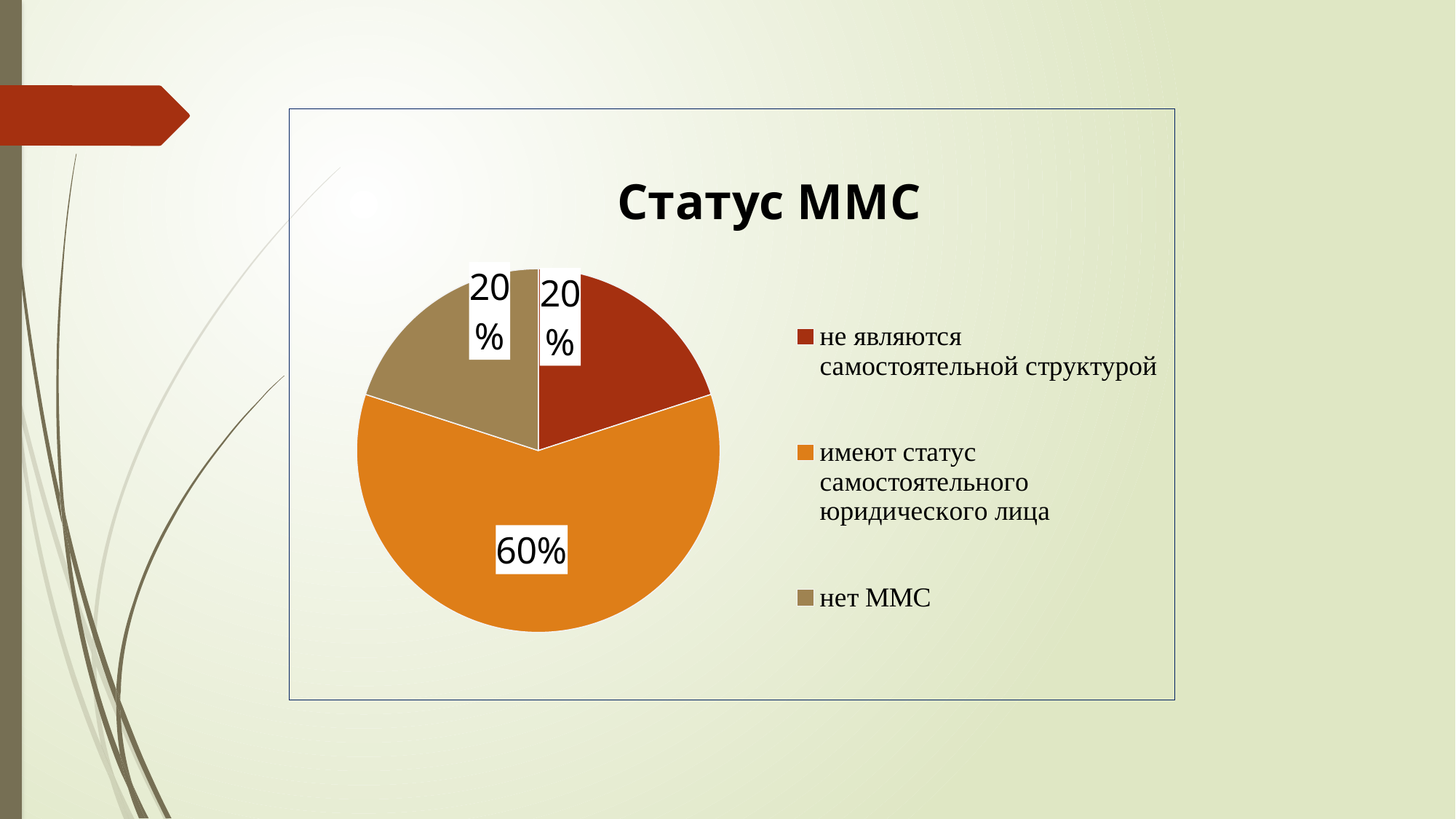
What is the difference between the share for 'имеют статус самостоятельного юридического лица' and the share for 'нет ММС'? 40% What is the combined share of 'не являются самостоятельной структурой' and 'нет ММС'? 40% What kind of chart is shown on the slide? pie chart What is the title of the chart? Статус ММС What share of the pie is 'нет ММС'? 20% How many entries does the legend list? 3 Which category has the largest slice of the pie? имеют статус самостоятельного юридического лица What colour is the slice for 'нет ММС'? brown How many slices does the pie chart have? 3 Which is larger: the share for 'имеют статус самостоятельного юридического лица' or the share for 'не являются самостоятельной структурой'? имеют статус самостоятельного юридического лица What share of the pie is 'имеют статус самостоятельного юридического лица'? 60% What share of the pie is 'не являются самостоятельной структурой'? 20%